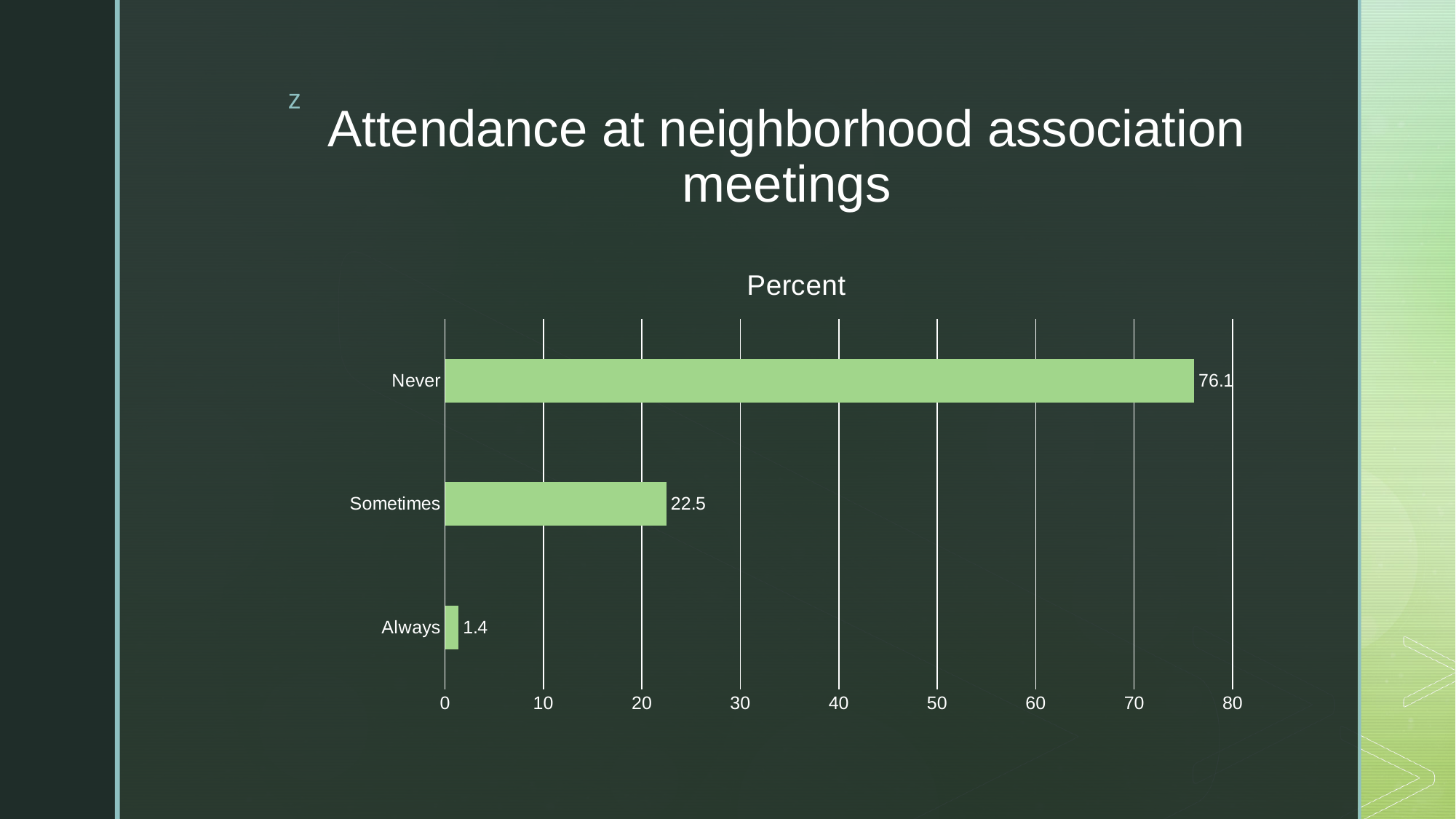
Which is larger, the value for Sometimes or the value for Always? Sometimes Which category has the lowest value? Always What is the value for Always? 1.4 How many categories are shown in the chart? 3 What kind of chart is shown on the slide? bar chart What is the difference between the values for Never and Sometimes? 53.6 What is the title of the chart? Percent Which category has the highest value? Never Is the value for Never greater or less than 70? greater What is the difference between the values for Sometimes and Always? 21.1 What is the value for Never? 76.1 What is the value for Sometimes? 22.5